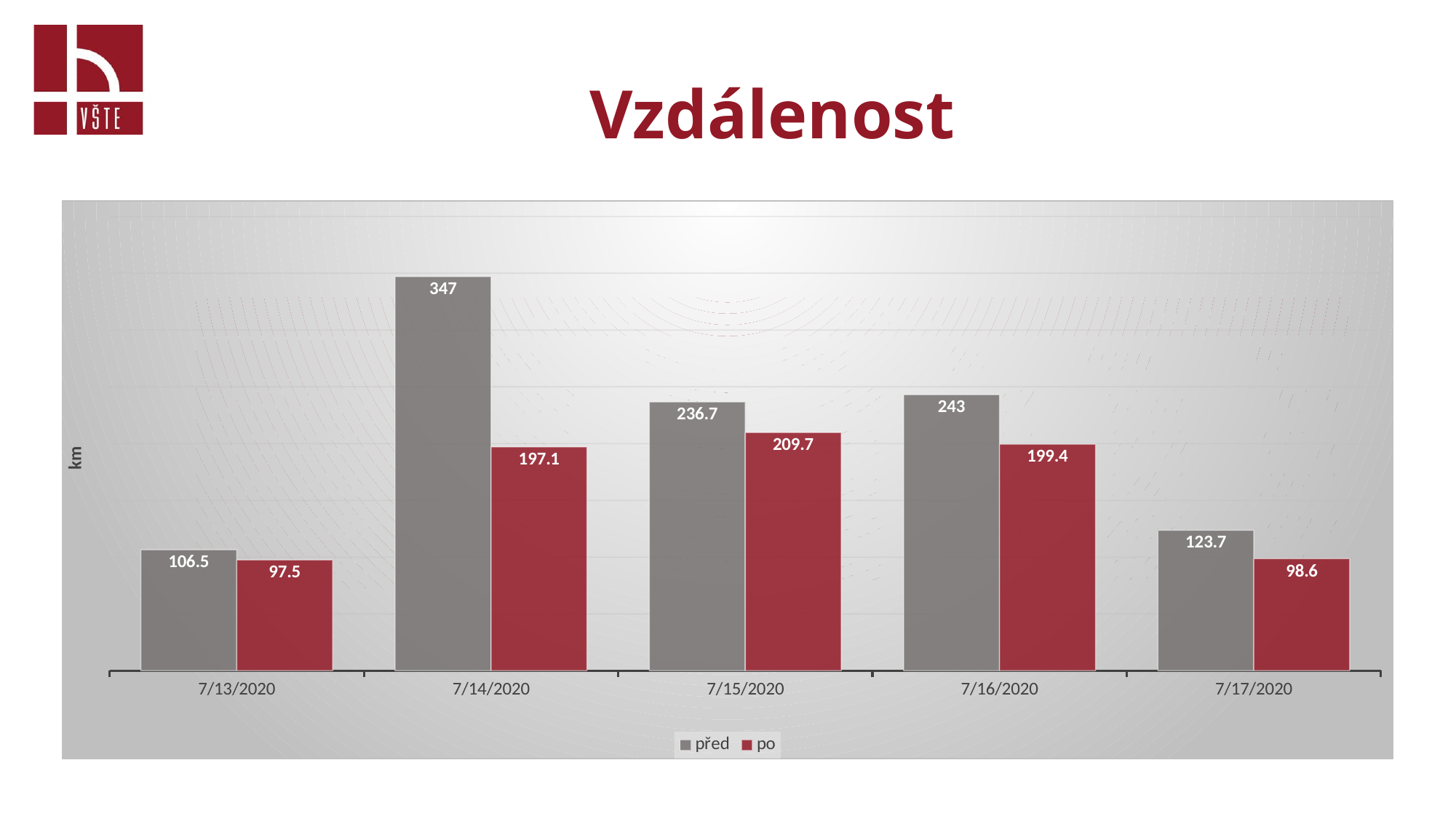
What is the 'před' value for 7/16/2020? 243 What is the label on the vertical axis? km How many series does the legend list? 2 Which is larger for 7/13/2020, the 'před' value or the 'po' value? před What is the difference between the 'před' and 'po' values for 7/14/2020? 149.9 What is the 'po' value for 7/15/2020? 209.7 What kind of chart is shown on the slide? bar chart How many dates are shown on the x axis? 5 What is the 'po' value for 7/17/2020? 98.6 Which date has the highest 'před' value? 7/14/2020 What is the 'před' value for 7/14/2020? 347 Which date has the lowest 'po' value? 7/13/2020